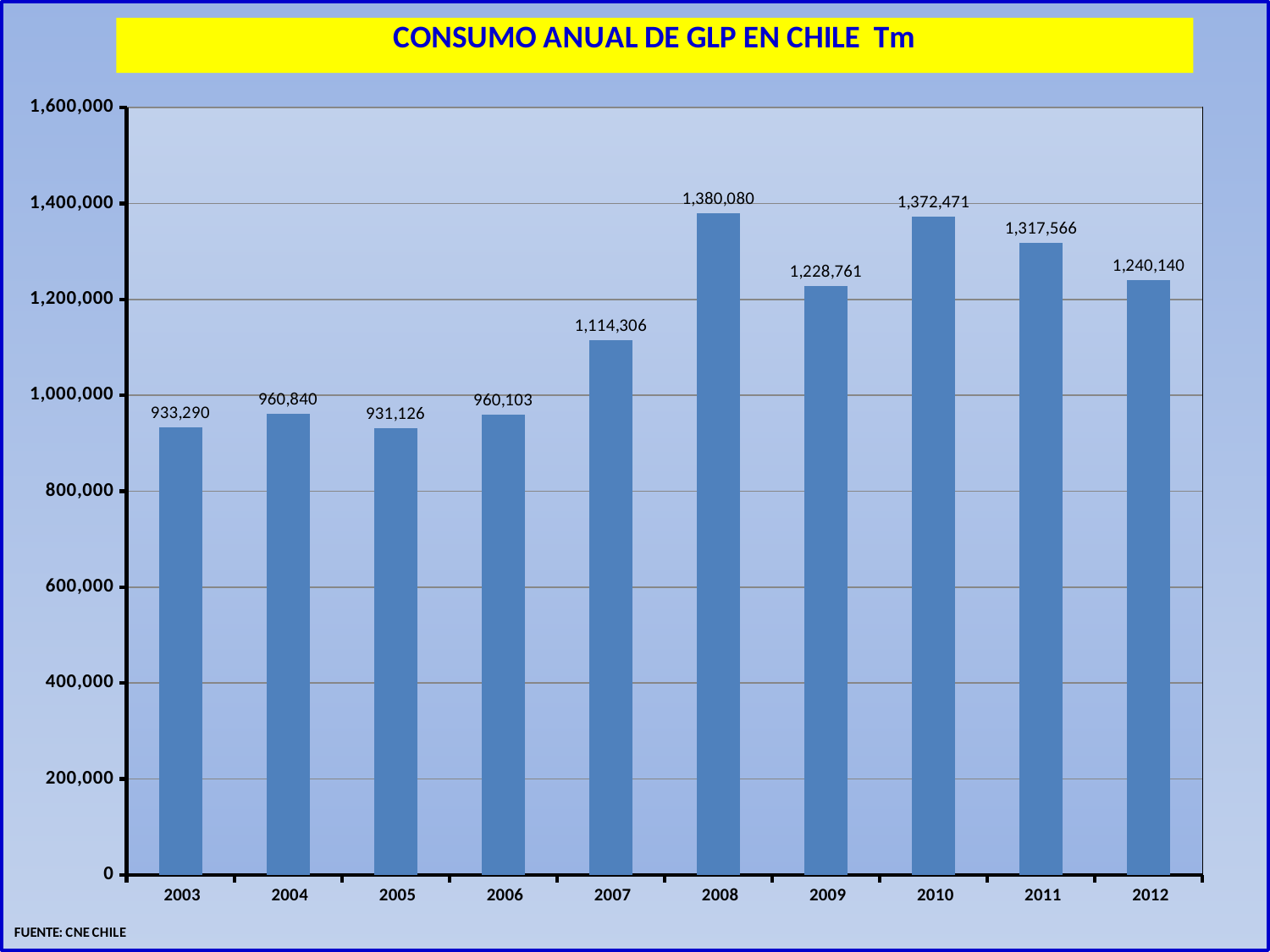
How many years are shown on the x axis? 10 Is the value for 2007 greater or less than 1,000,000? greater What value is shown for 2003? 933,290 Which is larger, the value for 2011 or the value for 2012? 2011 What is the title of the chart? CONSUMO ANUAL DE GLP EN CHILE Tm What kind of chart is this? bar chart Which year has the lowest consumption? 2005 What was the annual LPG consumption in Chile in 2008? 1,380,080 What is the difference between the 2008 and 2003 values? 446,790 What is the difference between the 2010 and 2009 values? 143,710 What value is shown for 2012? 1,240,140 Which year has the highest consumption? 2008